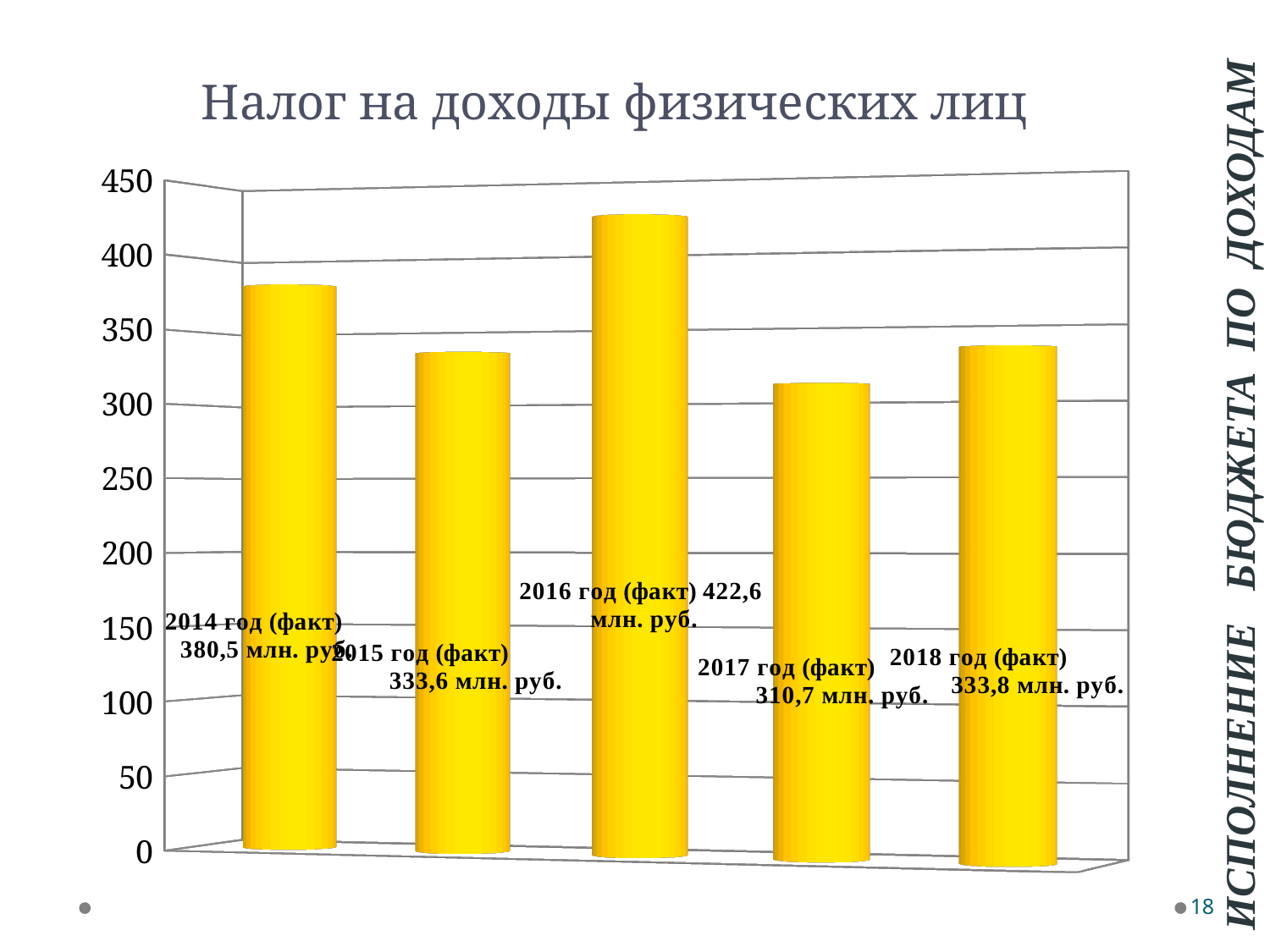
What is the value for 2017 год (факт)? 310,7 млн. руб. What kind of chart is shown on the slide? bar chart How many bars are shown in the chart? 5 What is the difference between the values for 2014 год (факт) and 2015 год (факт)? 46,9 млн. руб. What is the title of the chart? Налог на доходы физических лиц What is the value for 2014 год (факт)? 380,5 млн. руб. Is the value for 2016 год (факт) greater or less than 400? greater What is the difference between the values for 2016 год (факт) and 2017 год (факт)? 111,9 млн. руб. Which year has the lowest value? 2017 год (факт) Which year has the highest value? 2016 год (факт) What is the value for 2018 год (факт)? 333,8 млн. руб. Which is larger, the value for 2014 год (факт) or 2018 год (факт)? 2014 год (факт)